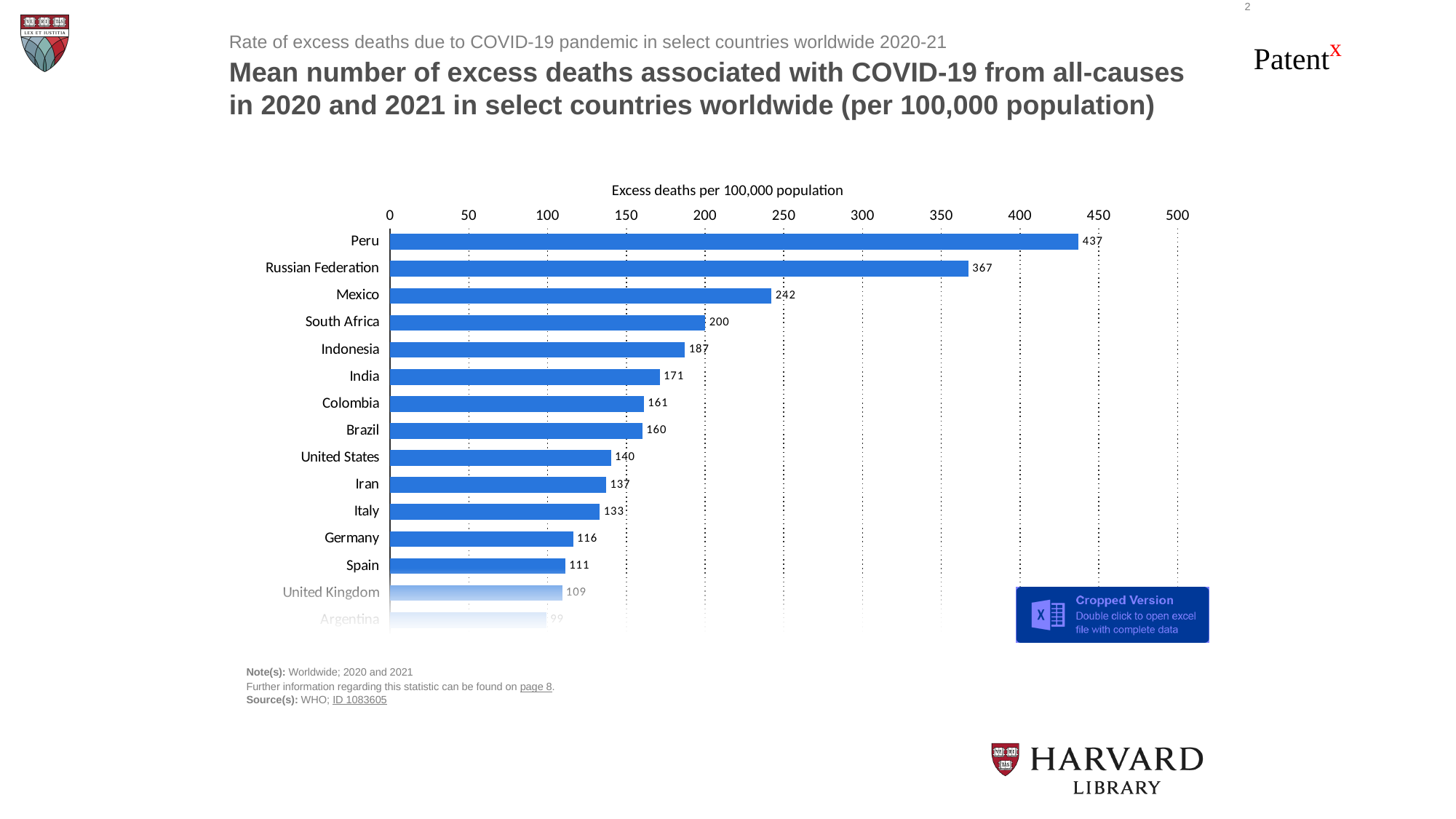
What is the difference between the values for Peru and the Russian Federation? 70 Is the value for Mexico greater or less than 200? greater What is the title shown above the chart's axis? Excess deaths per 100,000 population What kind of chart is shown on the slide? Bar chart What is the value shown for Germany? 116 What is the mean number of excess deaths per 100,000 population for Peru? 437 Which country has the highest rate of excess deaths per 100,000 population? Peru What value is shown for the Russian Federation? 367 Which has a higher value, Italy or Spain? Italy What is the value for Mexico? 242 Which has a higher value, India or the United States? India What is the difference between the values for South Africa and Indonesia? 13